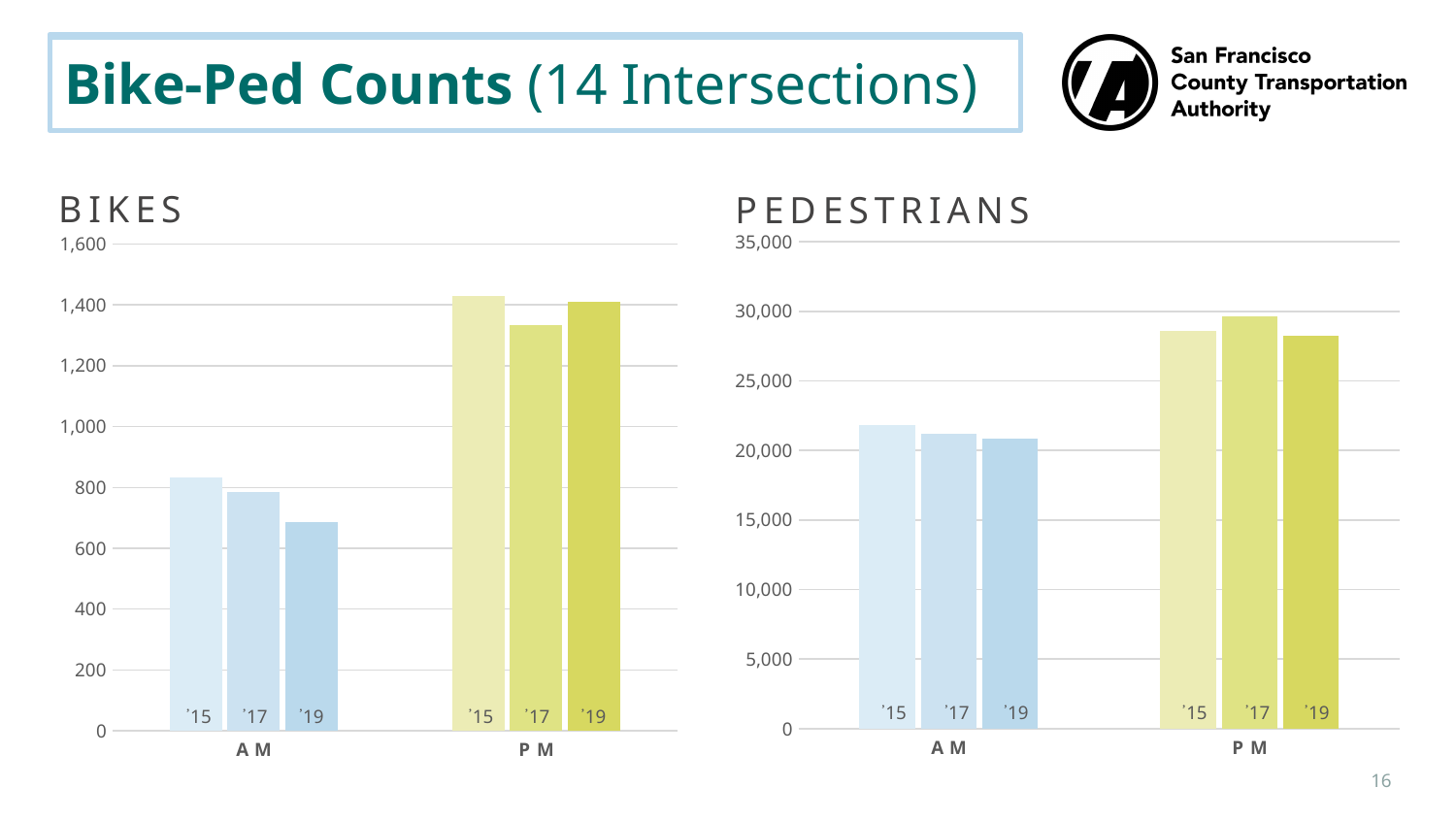
In the PEDESTRIANS chart, which bar is the highest? PM '17 In the BIKES chart, which is larger, AM '15 or AM '19? AM '15 In the BIKES chart, which bar is the lowest? AM '19 How many charts are shown on the slide? 2 In the PEDESTRIANS chart, do the AM bars rise or fall from '15 to '19? fall In the PEDESTRIANS chart, is the value for AM '15 greater or less than 20,000? greater In the BIKES chart, is the value for AM '19 greater or less than 800? less What kind of chart is the BIKES chart? bar chart In the BIKES chart, is the value for PM '17 greater or less than 1,200? greater How many bars are plotted in the BIKES chart? 6 In the BIKES chart, do the AM bars rise or fall from '15 to '19? fall